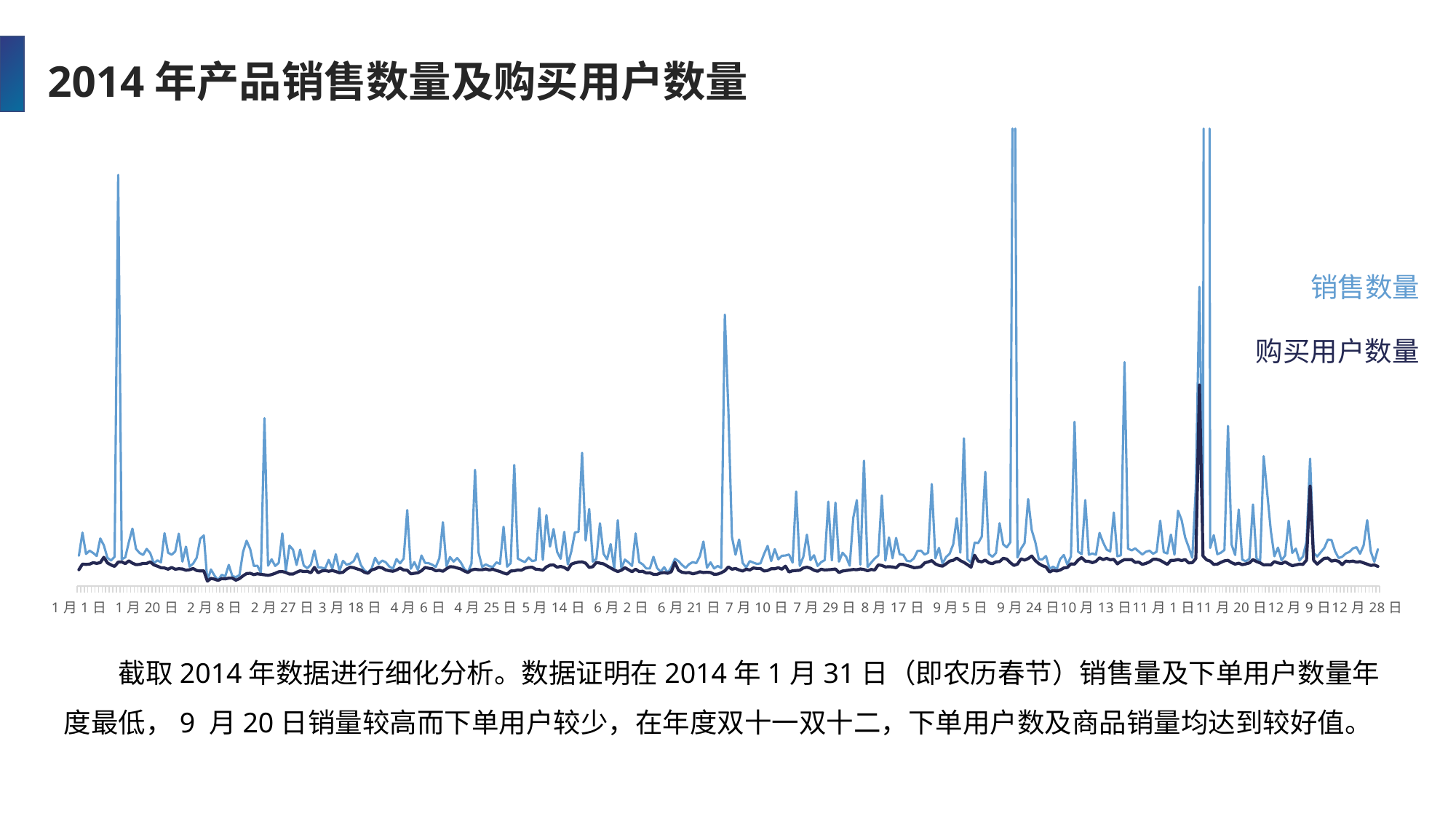
How many date labels are printed along the x axis? 20 What is the last date label on the x axis? 12 月 28 日 Which series has the tallest spikes on the chart, 销售数量 or 购买用户数量? 销售数量 Does the 购买用户数量 line stay mostly flat near the bottom of the chart or rise steadily across the year? Mostly flat near the bottom Around which x-axis date does the 购买用户数量 series reach its highest peak? 11 月 11 日 At the 11 月 11 日 spike, which series is higher, 销售数量 or 购买用户数量? 销售数量 How many series does the chart's legend list? 2 What are the two series named in the chart's legend? 销售数量 and 购买用户数量 What kind of chart is shown on the slide? Line chart Which series is drawn in the dark navy colour? 购买用户数量 What is the first date label on the x axis? 1 月 1 日 Which series generally runs higher across the year, 销售数量 or 购买用户数量? 销售数量